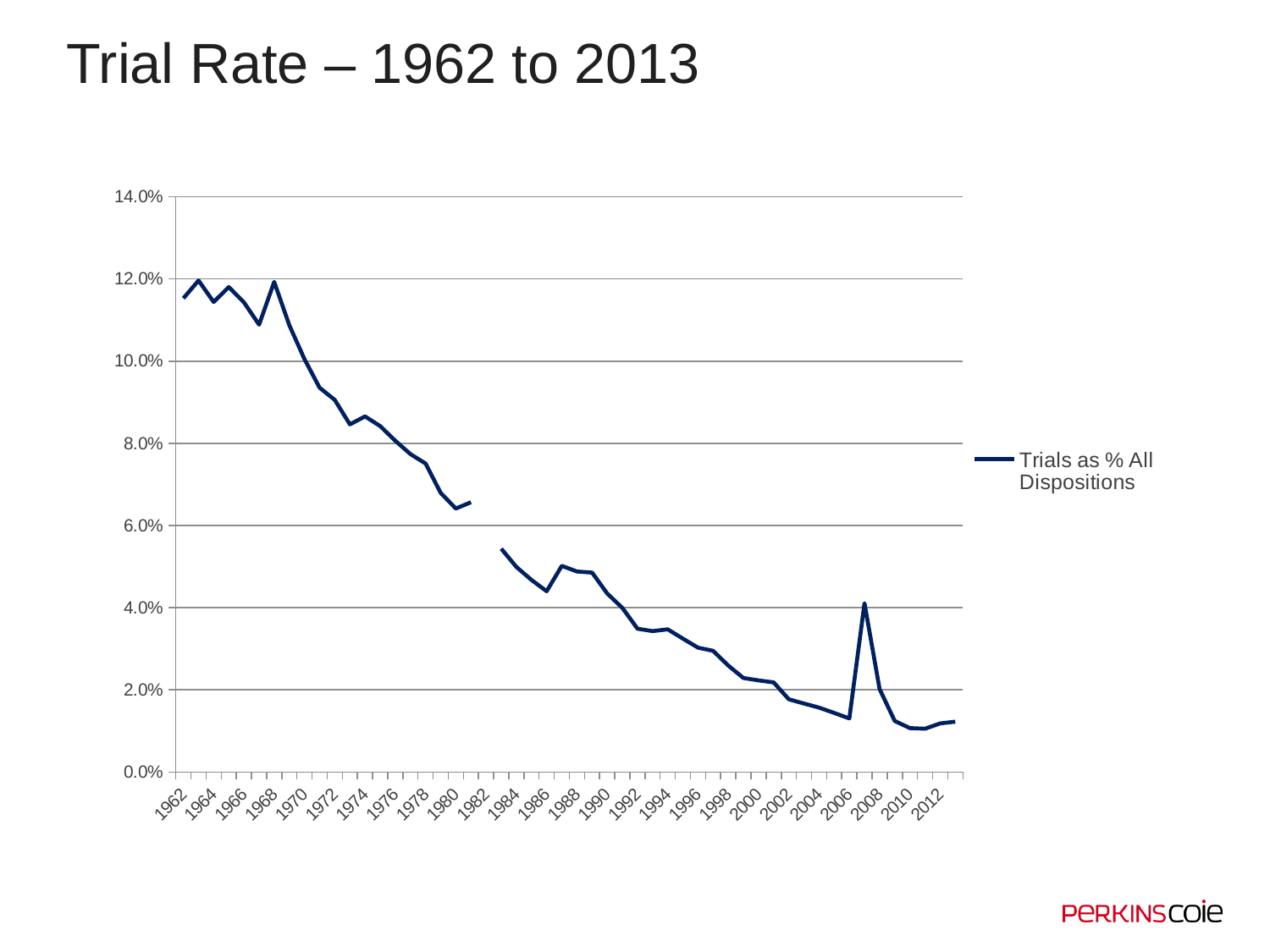
Is the value for 1986 greater or less than 6.0%? less Is the value for 2007 greater or less than 2.0%? greater Is the value for 2010 greater or less than 2.0%? less What is the title of the slide's chart? Trial Rate – 1962 to 2013 Which year has the larger value, 1970 or 1990? 1970 What is the legend entry for the plotted series? Trials as % All Dispositions Which year has the larger value, 2006 or 2007? 2007 How many series does the legend list? 1 What kind of chart is shown on the slide? line chart Overall, do the values rise or fall from 1962 to 2013? fall